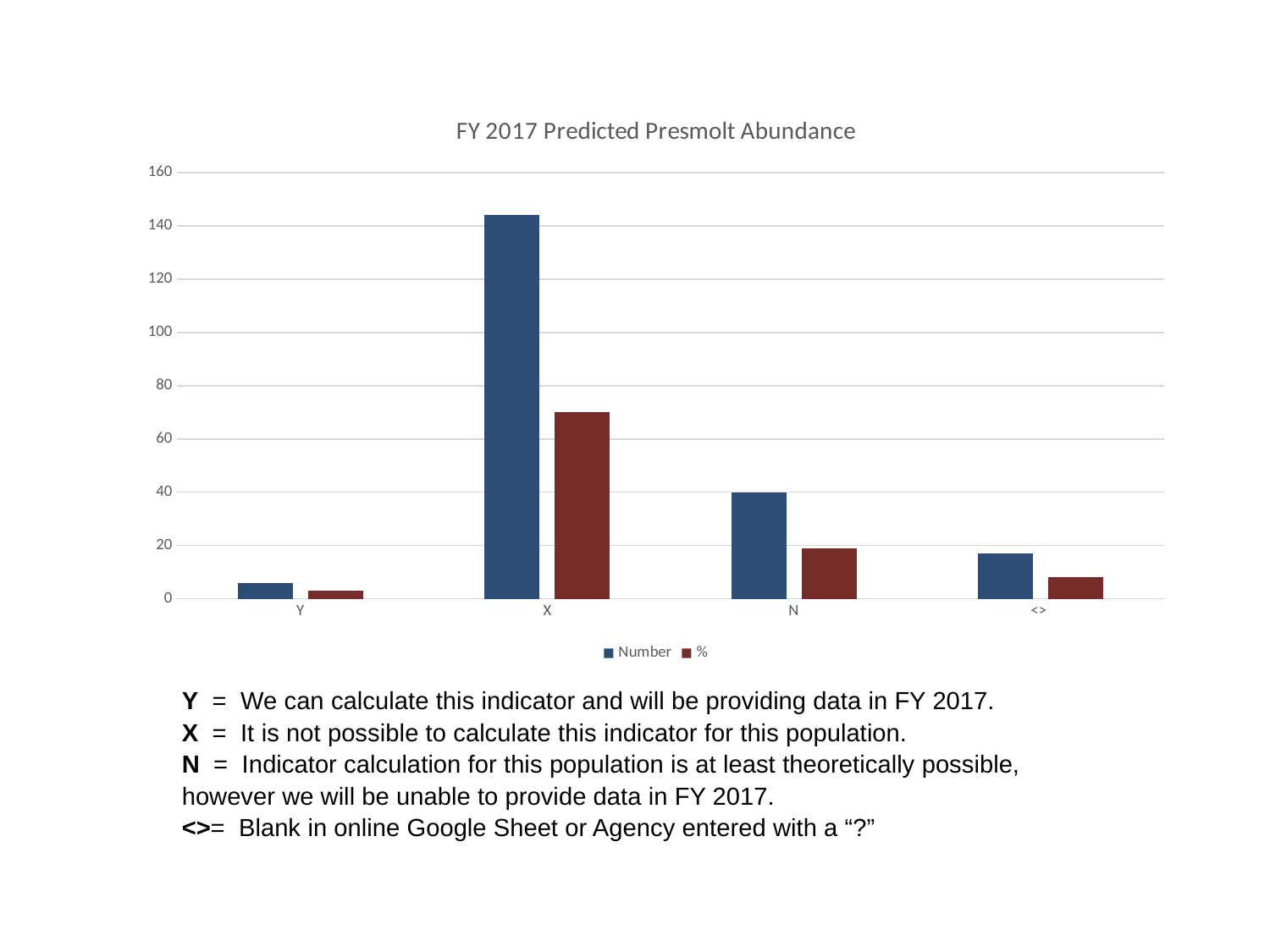
How many series does the legend list? 2 Is the Number value for X greater or less than 140? greater Which category has the highest Number value? X Which category has the highest % value? X What kind of chart is shown on the slide? bar chart Is the Number value for <> greater or less than 20? less Which is larger, the Number value for N or the Number value for <>? N Which category has the lowest Number value? Y How many categories are shown on the x axis? 4 What are the two series named in the legend? Number and % What is the title of the chart? FY 2017 Predicted Presmolt Abundance Is the % value for X greater or less than 80? less